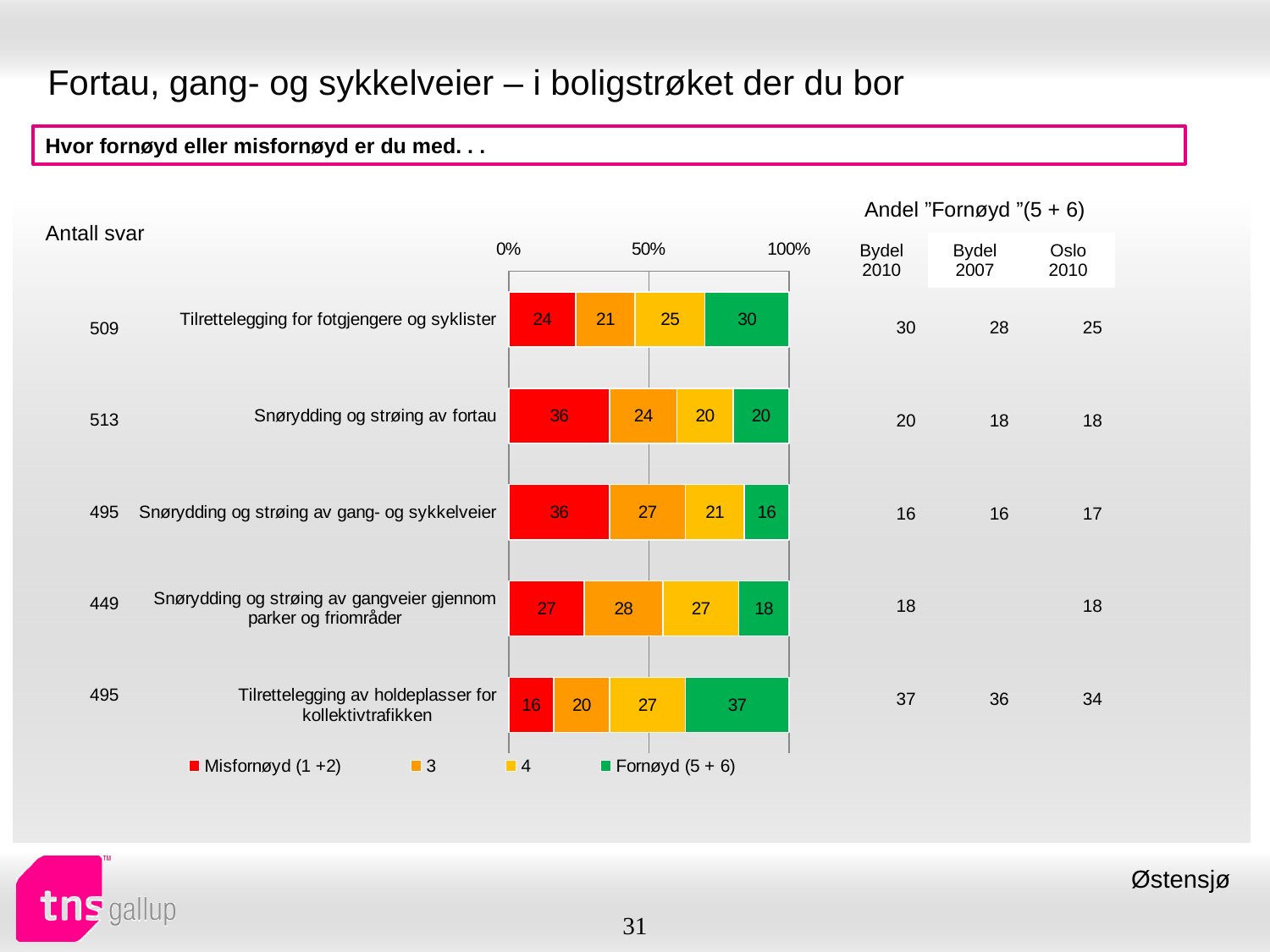
Which is larger: the "Fornøyd (5 + 6)" value for "Snørydding og strøing av fortau" or for "Snørydding og strøing av gangveier gjennom parker og friområder"? Snørydding og strøing av fortau What colour represents the "Fornøyd (5 + 6)" series in the chart? green What is the value of "Misfornøyd (1 +2)" for "Snørydding og strøing av fortau"? 36 What is the total of the stacked bar for "Tilrettelegging for fotgjengere og syklister"? 100 Which category has the lowest "Fornøyd (5 + 6)" value? Snørydding og strøing av gang- og sykkelveier What kind of chart is shown on the slide? stacked bar chart What is the value of series "3" for "Snørydding og strøing av gangveier gjennom parker og friområder"? 28 What is the value of "Fornøyd (5 + 6)" for "Tilrettelegging for fotgjengere og syklister"? 30 How many series does the legend list? 4 Which category has the highest "Fornøyd (5 + 6)" value? Tilrettelegging av holdeplasser for kollektivtrafikken How many categories (rows) does the bar chart show? 5 What is the difference between the "Misfornøyd (1 +2)" values for "Snørydding og strøing av fortau" and "Tilrettelegging av holdeplasser for kollektivtrafikken"? 20